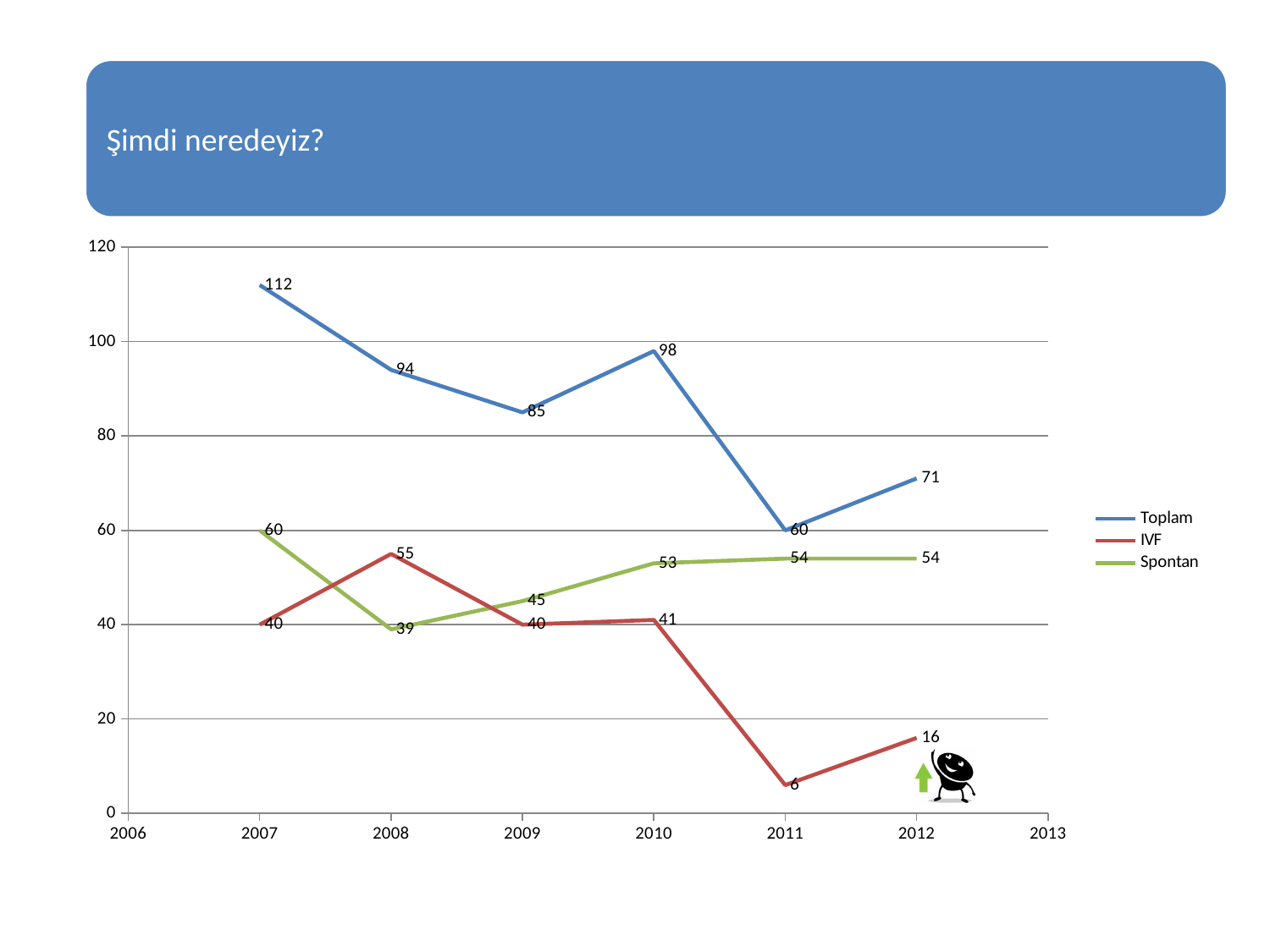
What kind of chart is shown on the slide? line chart Is the Toplam value in 2010 greater or less than 80? greater What is the value of the Spontan series in 2009? 45 What is the value of the IVF series in 2011? 6 What is the value of the Toplam series in 2007? 112 Does the Spontan series rise or fall from 2008 to 2011? rise How many series does the legend list? 3 Which is larger in 2008, the IVF value or the Spontan value? IVF What is the difference between the Toplam value in 2007 and the Toplam value in 2012? 41 In which year is the Toplam series at its lowest? 2011 In which year is the IVF series at its highest? 2008 What is the title of the slide containing the chart? Şimdi neredeyiz?